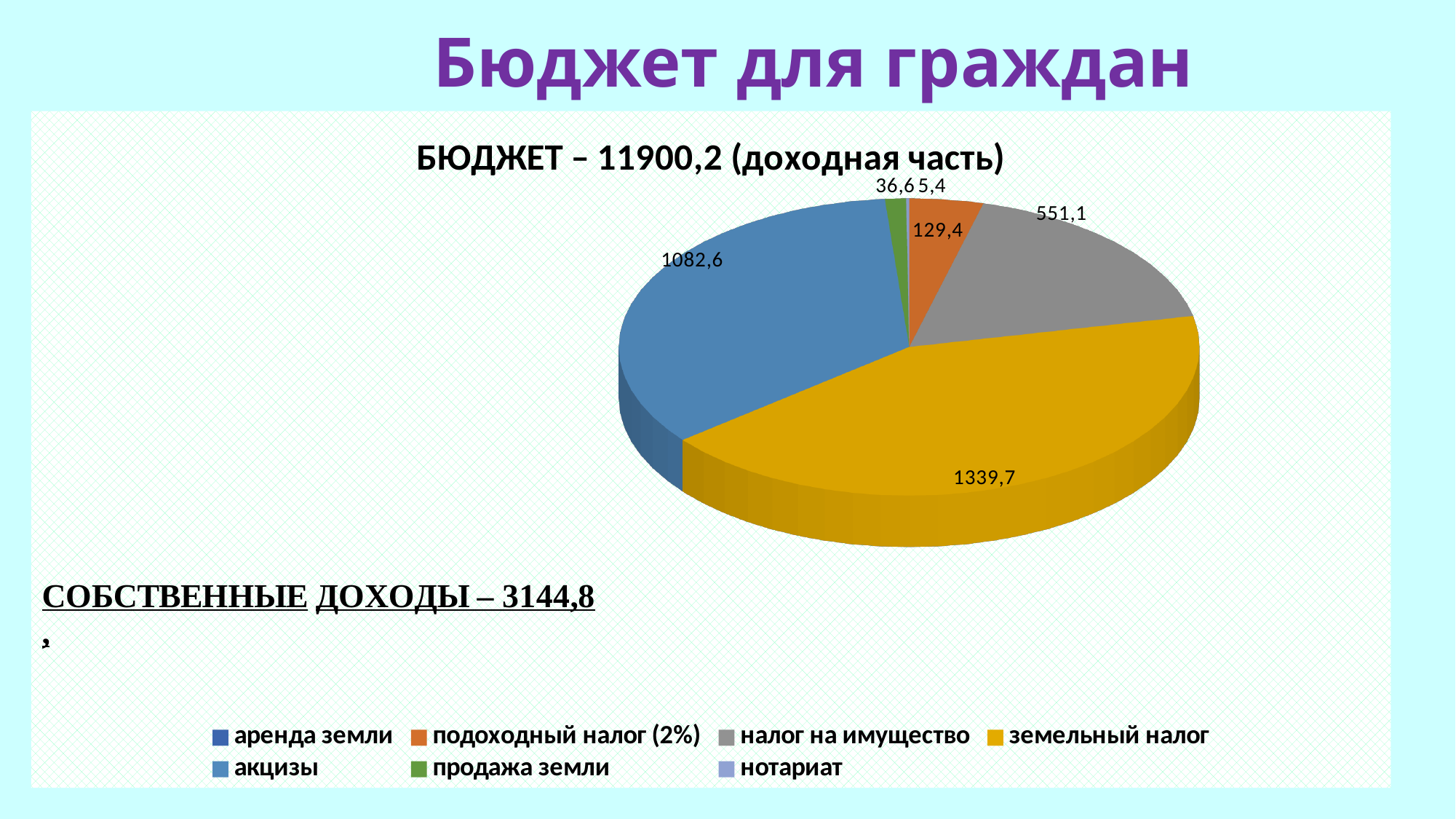
What type of chart is shown on the slide? pie chart What is the value for налог на имущество? 551,1 What is the value for земельный налог? 1339,7 What is the value for подоходный налог (2%)? 129,4 How many entries does the chart legend list? 7 What is the value for продажа земли? 36,6 What is the difference between the values for земельный налог and акцизы? 257,1 What is the value for акцизы? 1082,6 What colour is the slice for земельный налог? yellow Which category has the largest slice of the pie? земельный налог Which is larger, налог на имущество or подоходный налог (2%)? налог на имущество What is the title of the chart? БЮДЖЕТ – 11900,2 (доходная часть)